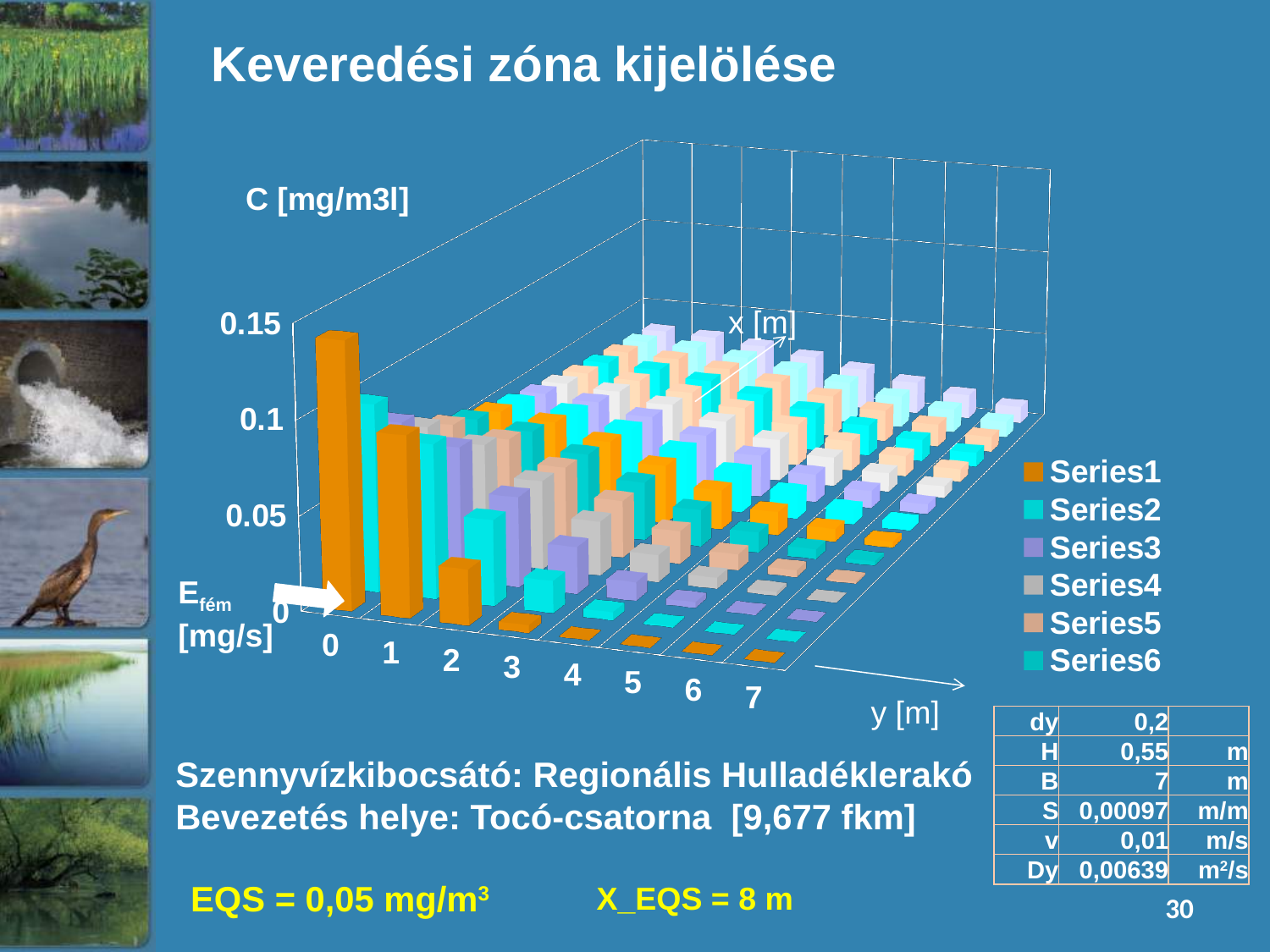
Is the value for Series1 at y = 0 greater or less than 0.1? greater Is the value for Series1 at y = 7 greater or less than 0.05? less Is the value for Series1 at y = 2 greater or less than 0.05? less What is the first entry in the chart legend? Series1 Which series has the tallest bar at y = 0? Series1 Which is larger, the Series1 bar at y = 0 or the Series1 bar at y = 2? Series1 at y = 0 What is the label of the vertical axis of the chart? C [mg/m3l] How many series does the legend list? 6 What kind of chart is shown on the slide? bar chart Do the Series1 values rise or fall as y increases from 0 to 7? fall How many categories are labelled along the y [m] axis? 8